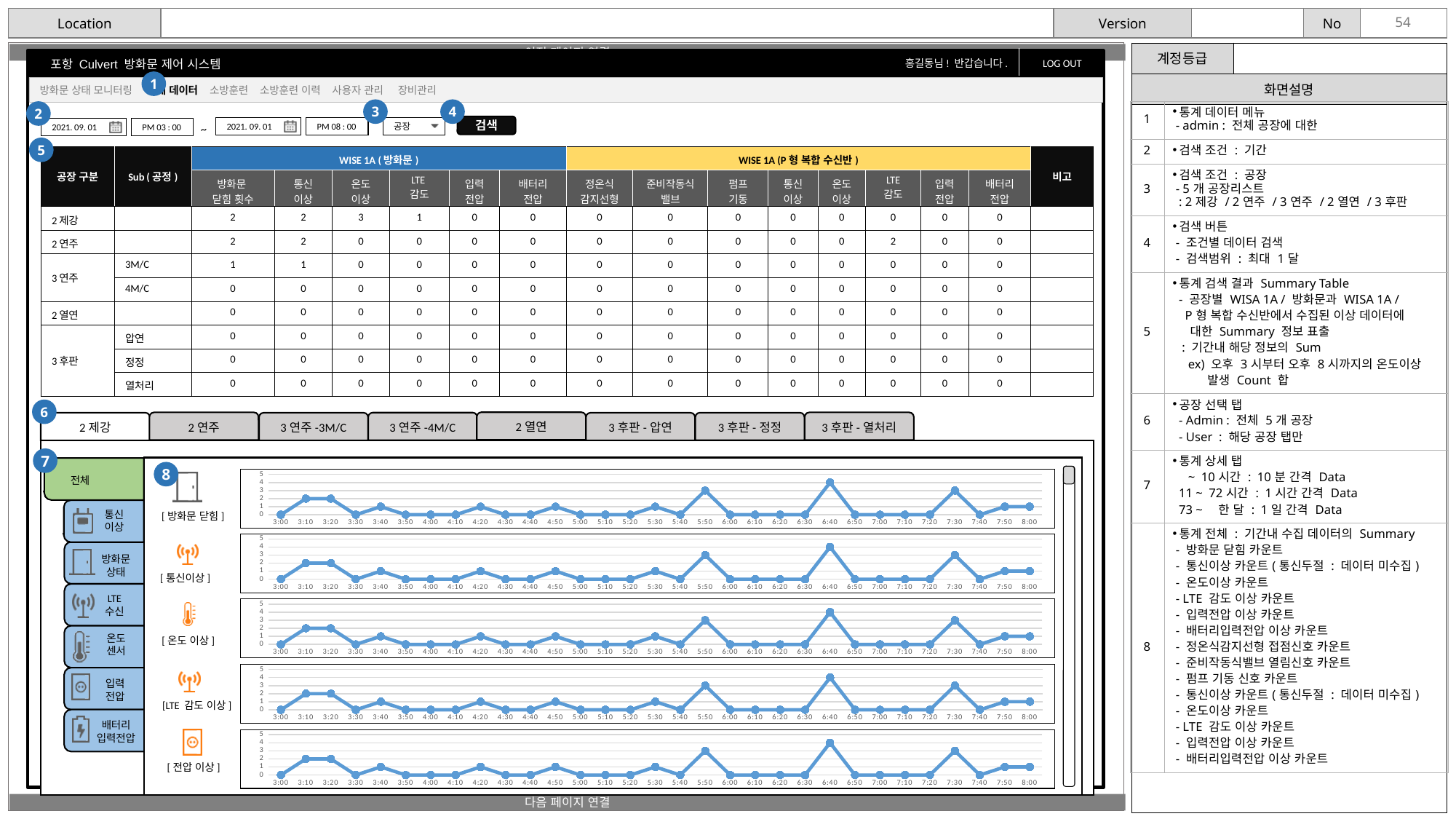
In the [온도 이상] line chart, which is larger, the value at 6:40 or the value at 7:00? 6:40 In the [전압 이상] line chart, is the value at 4:00 greater or less than 2? less In the [방화문 닫힘] line chart, is the value at 3:00 greater or less than 1? less How many data points are plotted along the x axis of the [방화문 닫힘] line chart (from 3:00 to 8:00 at 10-minute intervals)? 31 In the [통신이상] line chart, is the value at 6:40 greater or less than 2? greater In the [방화문 닫힘] line chart, at which time does the line reach its highest point? 6:40 What is the first time label on the x axis of the [LTE 감도 이상] line chart? 3:00 What is the last time label on the x axis of the [방화문 닫힘] line chart? 8:00 What kind of chart is the [방화문 닫힘] chart at the bottom of the slide? line chart How many line charts are shown in the lower section of the slide? 5